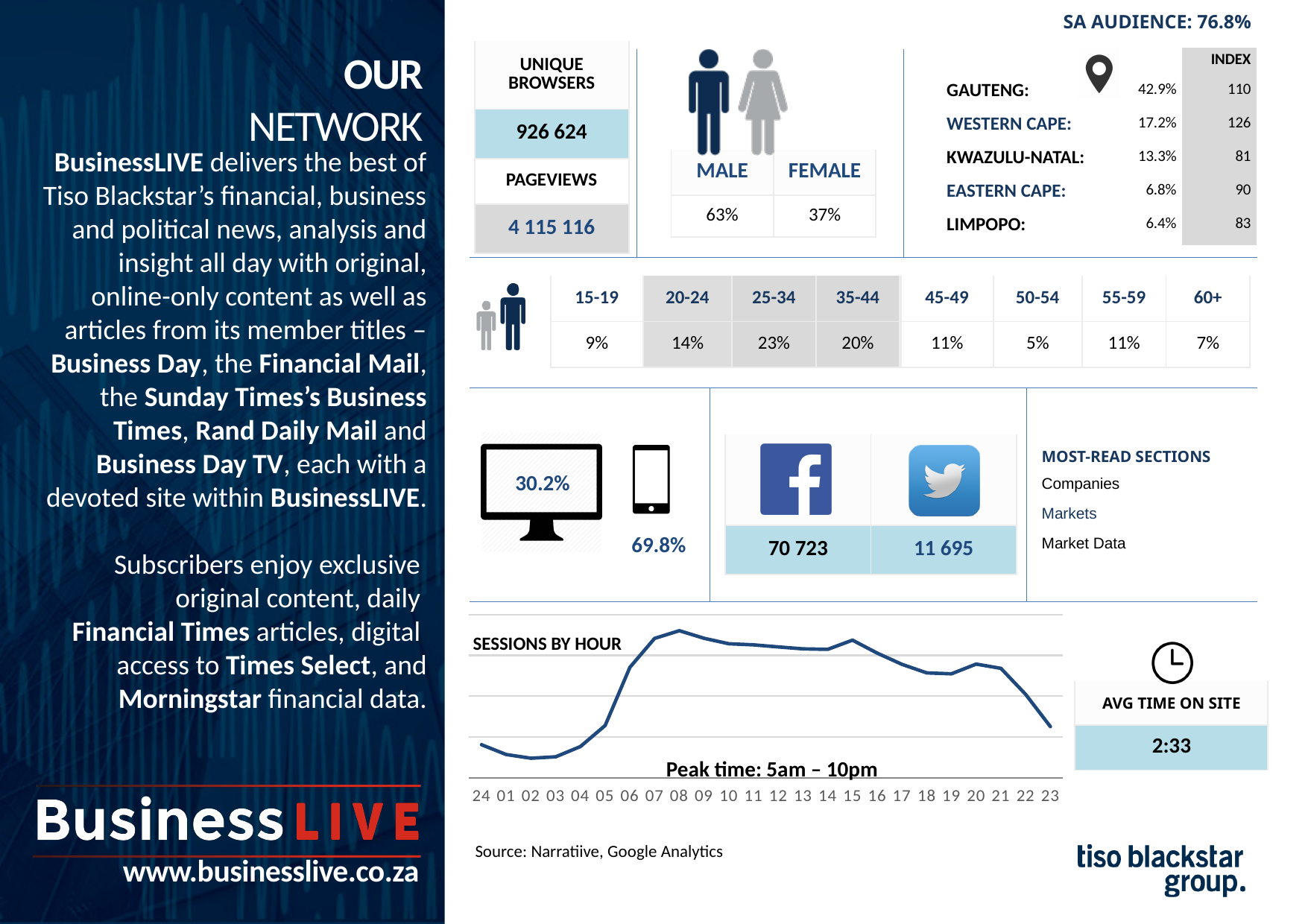
On the "Sessions by Hour" chart, which hour has more sessions, 08 or 03? 08 What is the title of the chart at the bottom of the slide? SESSIONS BY HOUR On the "Sessions by Hour" chart, do sessions rise or fall between hour 04 and hour 08? rise On the "Sessions by Hour" chart, which hour has more sessions, 15 or 23? 15 How many hour labels are shown along the x axis of the "Sessions by Hour" chart? 24 What is the first hour label on the x axis of the "Sessions by Hour" chart? 24 What kind of chart is the "Sessions by Hour" chart? line chart On the "Sessions by Hour" chart, which hour has more sessions, 02 or 10? 10 What peak time is annotated on the "Sessions by Hour" chart? 5am – 10pm How many lines are plotted on the "Sessions by Hour" chart? 1 On the "Sessions by Hour" chart, do sessions rise or fall between hour 20 and hour 23? fall At which hour does the "Sessions by Hour" line reach its highest point? 08